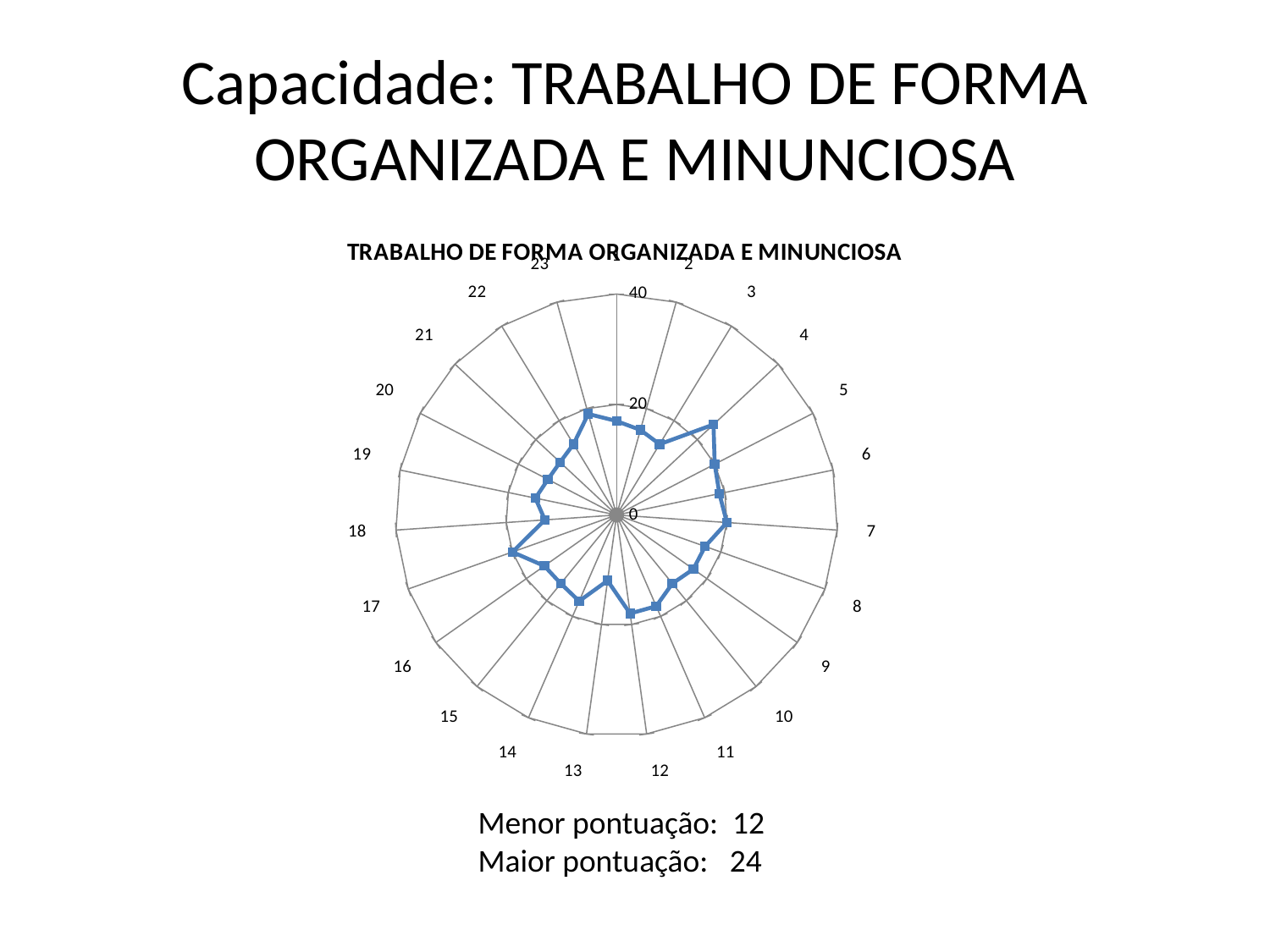
What is the highest value shown on the chart's radial axis? 40 What is the title of the chart? TRABALHO DE FORMA ORGANIZADA E MINUNCIOSA Which category has the highest value on the chart? 4 Is the value for category 21 greater or less than 20? less Is the value for category 13 greater or less than 20? less What kind of chart is shown on the slide? radar chart Which has the larger value, category 5 or category 20? category 5 Is the value for category 3 greater or less than 20? less Which has the larger value, category 5 or category 13? category 5 Which has the larger value, category 7 or category 13? category 7